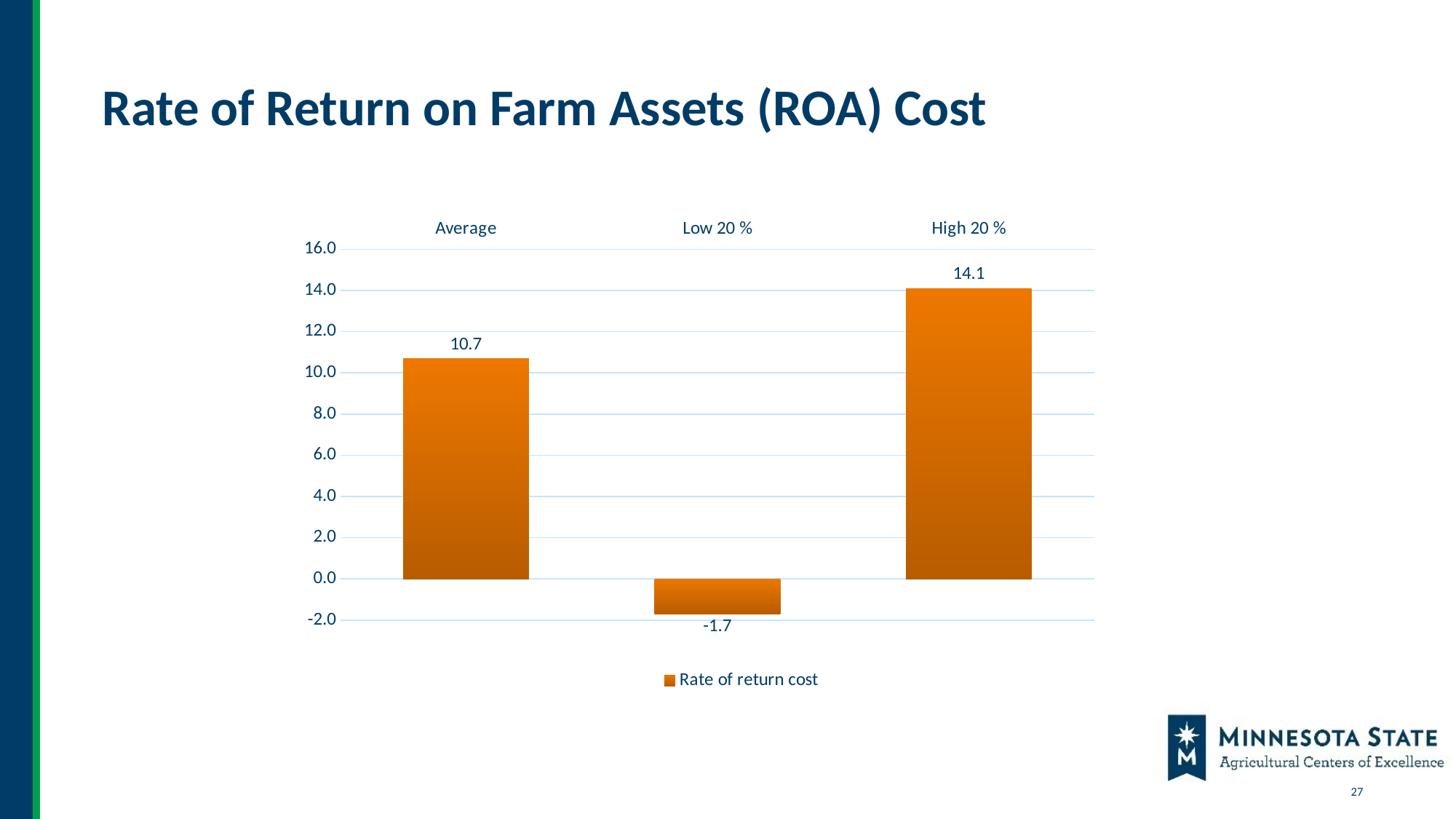
How many categories are shown in the chart? 3 Which category has the lowest rate of return cost? Low 20 % Is the value for Average greater or less than 12.0? less Which category has the highest rate of return cost? High 20 % What is the difference between the Average and Low 20 % values? 12.4 Which is larger, the value for Average or the value for High 20 %? High 20 % What is the rate of return cost for the Low 20 % category? -1.7 What is the rate of return cost for the Average category? 10.7 What series name does the legend show? Rate of return cost What kind of chart is shown on the slide? Bar chart What is the rate of return cost for the High 20 % category? 14.1 What is the difference between the High 20 % and Average values? 3.4